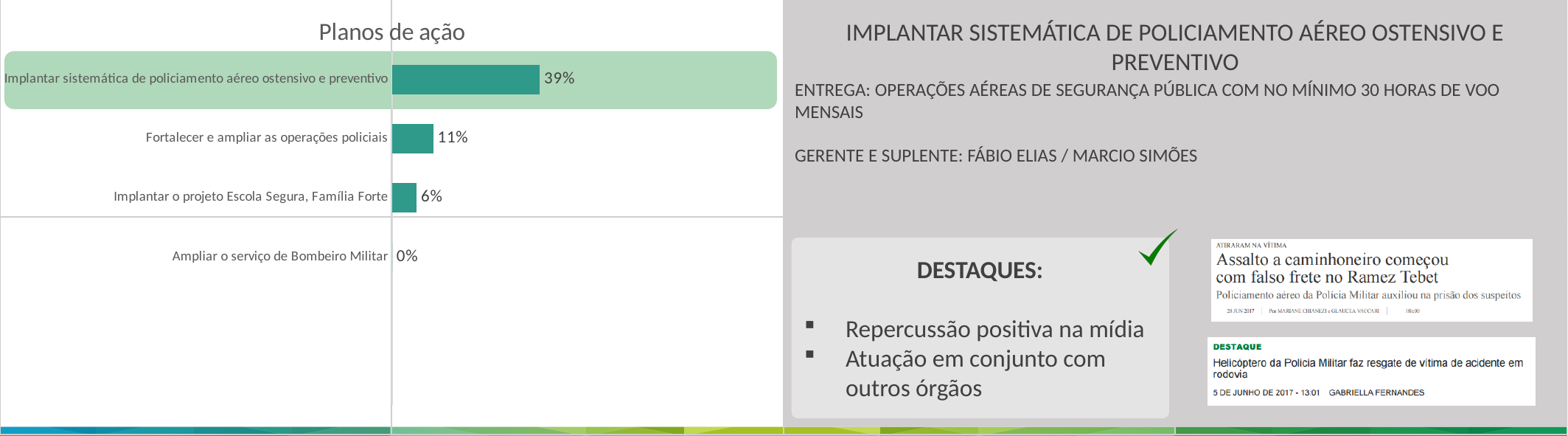
What is the value for "Fortalecer e ampliar as operações policiais" in the Planos de ação chart? 11% Which category has the highest value in the Planos de ação chart? Implantar sistemática de policiamento aéreo ostensivo e preventivo Which is larger in the Planos de ação chart: the value for "Fortalecer e ampliar as operações policiais" or for "Implantar o projeto Escola Segura, Família Forte"? Fortalecer e ampliar as operações policiais What is the difference between the values for "Implantar sistemática de policiamento aéreo ostensivo e preventivo" and "Fortalecer e ampliar as operações policiais" in the Planos de ação chart? 28% What is the value for "Implantar o projeto Escola Segura, Família Forte" in the Planos de ação chart? 6% Which category has the lowest value in the Planos de ação chart? Ampliar o serviço de Bombeiro Militar How many categories are shown in the Planos de ação chart? 4 What is the title of the chart on the left of the slide? Planos de ação What is the value for "Implantar sistemática de policiamento aéreo ostensivo e preventivo" in the Planos de ação chart? 39% What kind of chart is the Planos de ação chart? Bar chart What is the difference between the values for "Fortalecer e ampliar as operações policiais" and "Implantar o projeto Escola Segura, Família Forte" in the Planos de ação chart? 5% What is the value for "Ampliar o serviço de Bombeiro Militar" in the Planos de ação chart? 0%